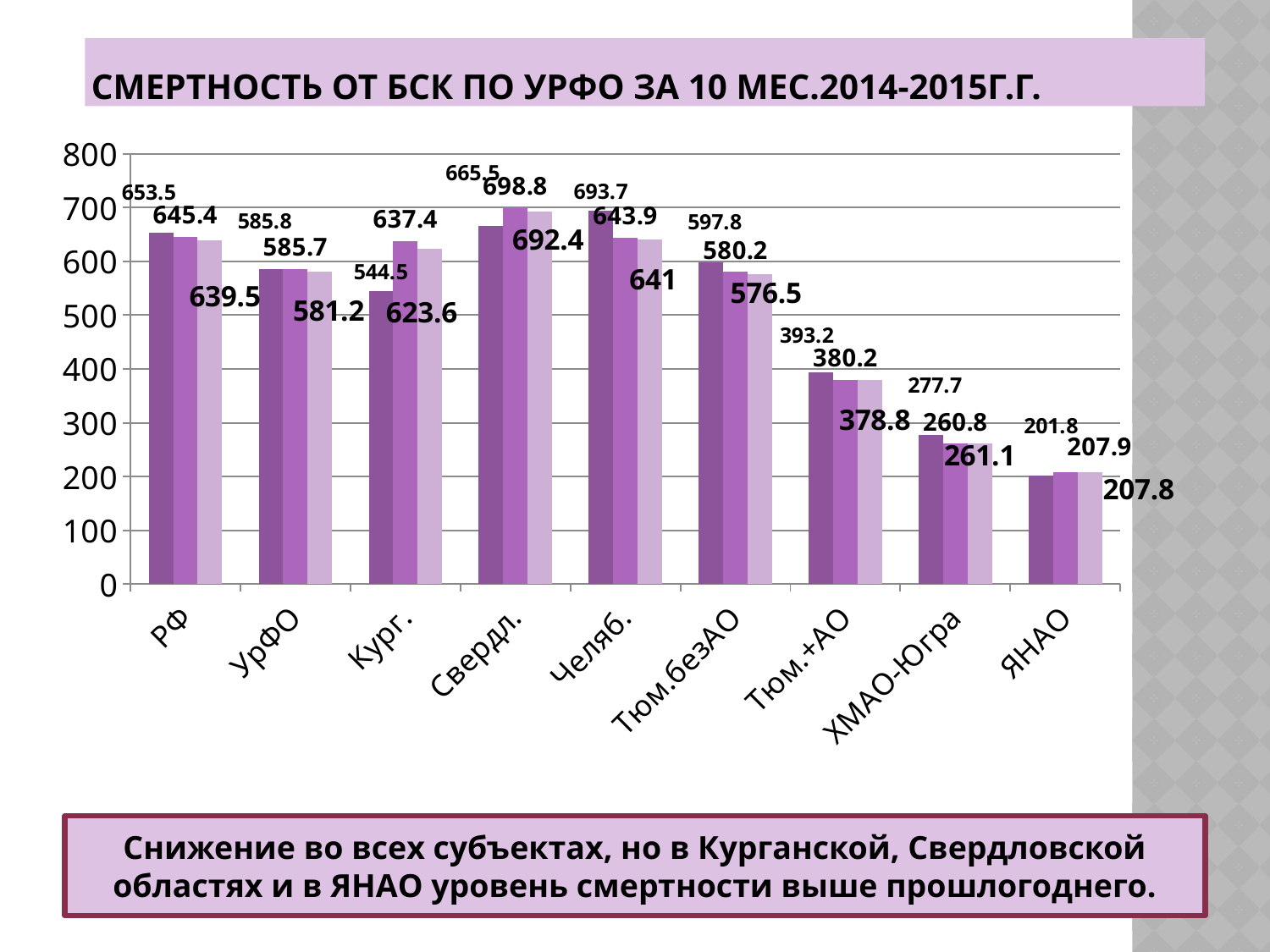
Which is larger for Кург.: the first (darkest) bar or the second bar? the second bar (637.4) Which category has the highest value among the first (darkest) bars? Челяб. What is the value of the first (darkest) bar for ЯНАО? 201.8 Is the value of the first (darkest) bar for ХМАО-Югра greater or less than 300? less How many categories are shown on the x axis of the chart? 9 What is the value of the first (darkest) bar for РФ? 653.5 What is the value of the third (lightest) bar for Свердл.? 692.4 What is the difference between the first (darkest) bar and the third (lightest) bar for Тюм.безАО? 21.3 Which category has the lowest value among the third (lightest) bars? ЯНАО What type of chart is shown on the slide? bar chart What is the value of the second bar for Кург.? 637.4 What is the title of the chart on the slide? СМЕРТНОСТЬ ОТ БСК ПО УРФО ЗА 10 МЕС.2014-2015Г.Г.